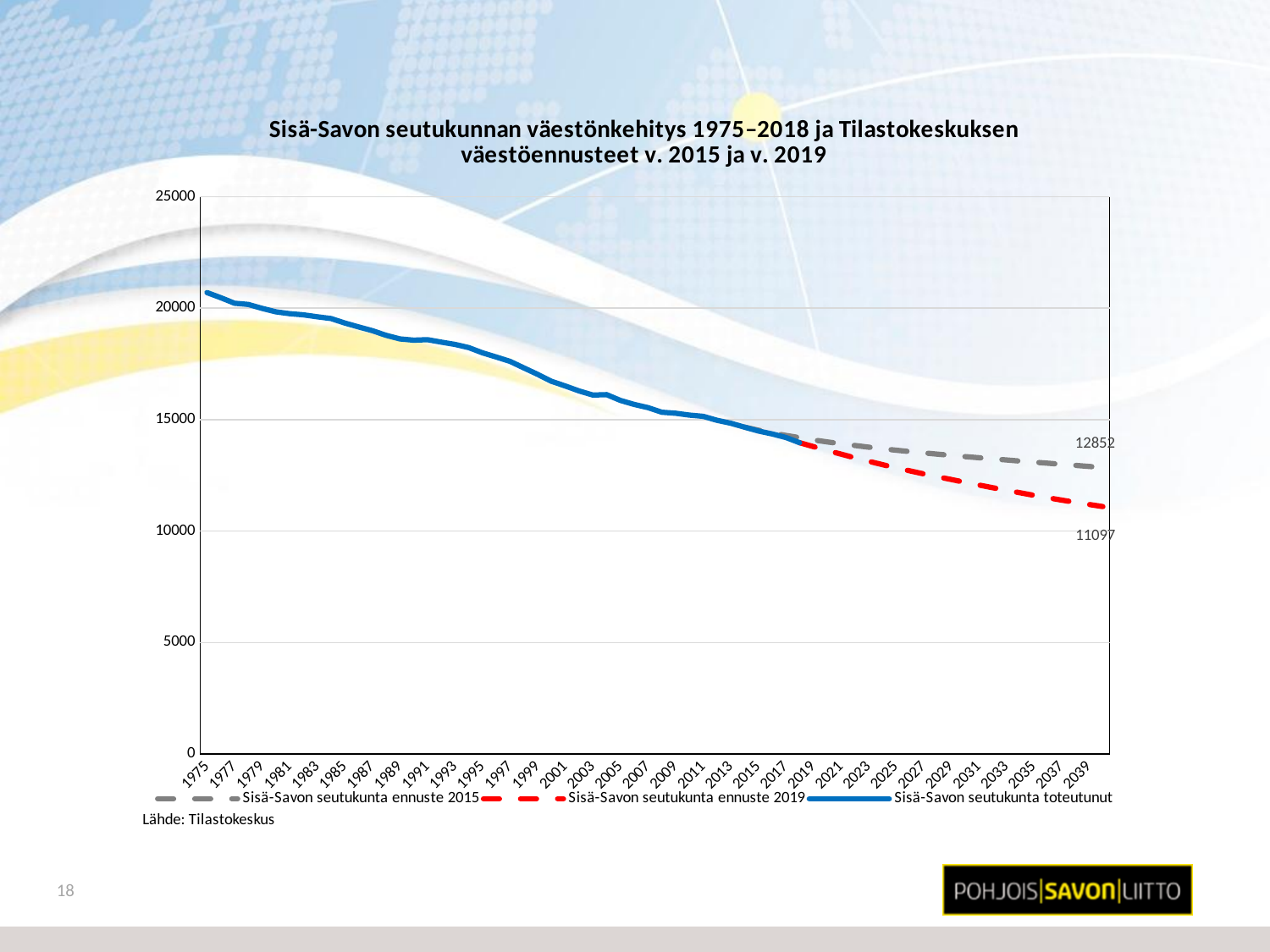
What is the final labelled value of the series 'Sisä-Savon seutukunta ennuste 2019'? 11097 Which forecast series ends at a higher value, 'ennuste 2015' or 'ennuste 2019'? Sisä-Savon seutukunta ennuste 2015 Does the 'Sisä-Savon seutukunta toteutunut' series rise or fall from 1975 to 2018? fall Is the value of 'Sisä-Savon seutukunta toteutunut' in 1995 greater or less than 15000? greater Is the value of 'Sisä-Savon seutukunta toteutunut' in 2017 greater or less than 15000? less How many series does the legend list? 3 What source is cited below the chart? Tilastokeskus What colour is the line for 'Sisä-Savon seutukunta toteutunut'? blue What is the final labelled value of the series 'Sisä-Savon seutukunta ennuste 2015'? 12852 Is the value of 'Sisä-Savon seutukunta toteutunut' in 1975 greater or less than 20000? greater What is the difference between the final labelled values of the 2015 forecast (12852) and the 2019 forecast (11097)? 1755 What kind of chart is shown on the slide? line chart